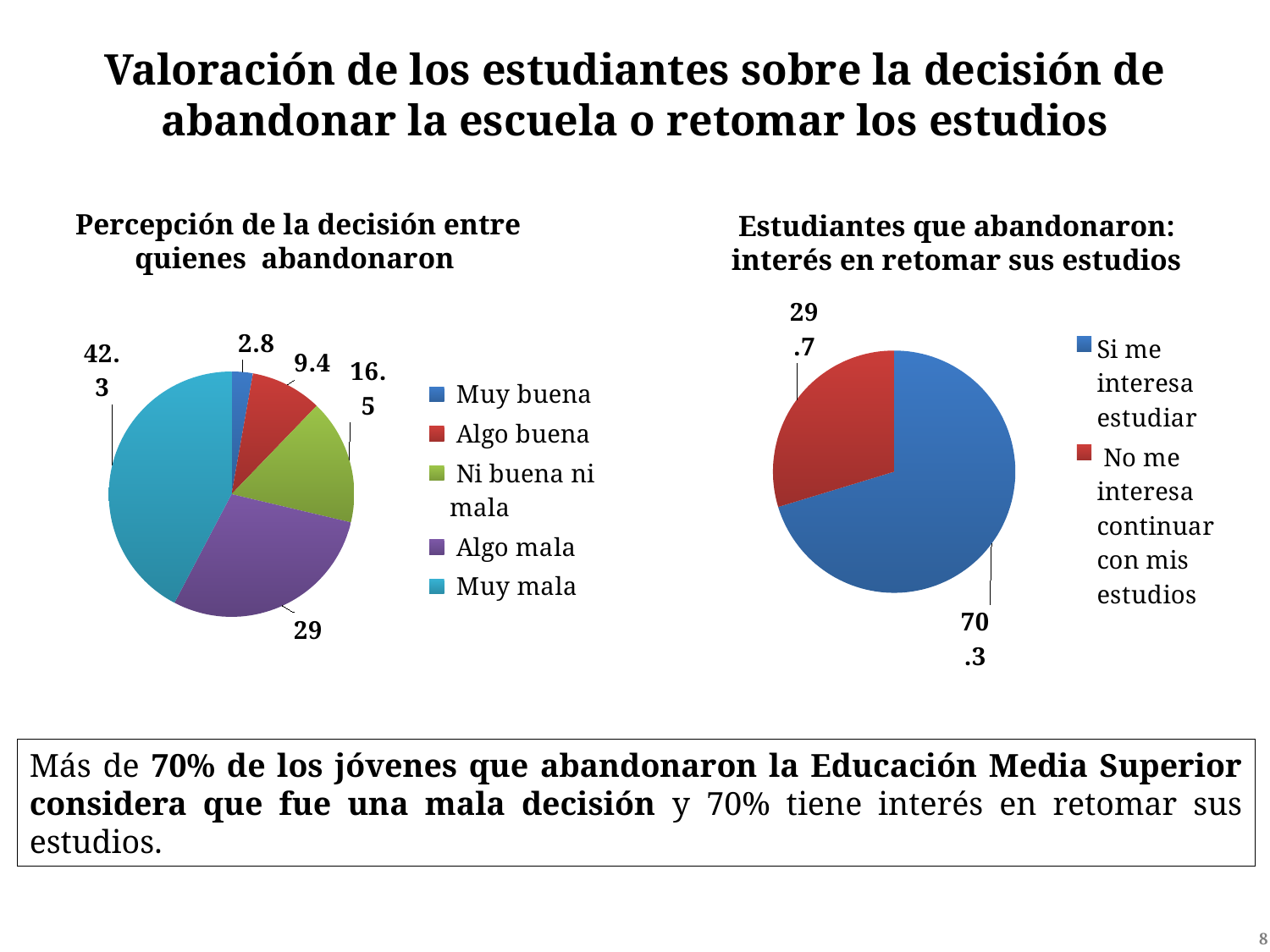
In the chart 'Estudiantes que abandonaron: interés en retomar sus estudios', what is the value for 'Si me interesa estudiar'? 70.3 In the chart 'Estudiantes que abandonaron: interés en retomar sus estudios', what is the value for 'No me interesa continuar con mis estudios'? 29.7 In the chart 'Percepción de la decisión entre quienes abandonaron', which category has the smallest slice? Muy buena In the chart 'Percepción de la decisión entre quienes abandonaron', what is the value for 'Algo buena'? 9.4 In the chart 'Percepción de la decisión entre quienes abandonaron', how many categories does the legend list? 5 In the chart 'Percepción de la decisión entre quienes abandonaron', what is the value for 'Ni buena ni mala'? 16.5 In the chart 'Percepción de la decisión entre quienes abandonaron', which is larger: 'Algo mala' or 'Ni buena ni mala'? Algo mala In the chart 'Estudiantes que abandonaron: interés en retomar sus estudios', what colour is the slice for 'Si me interesa estudiar'? Blue What kind of chart is 'Estudiantes que abandonaron: interés en retomar sus estudios'? Pie chart In the chart 'Percepción de la decisión entre quienes abandonaron', what is the value for 'Muy mala'? 42.3 In the chart 'Percepción de la decisión entre quienes abandonaron', which category has the largest slice? Muy mala In the chart 'Percepción de la decisión entre quienes abandonaron', what is the difference between 'Muy mala' and 'Algo mala'? 13.3